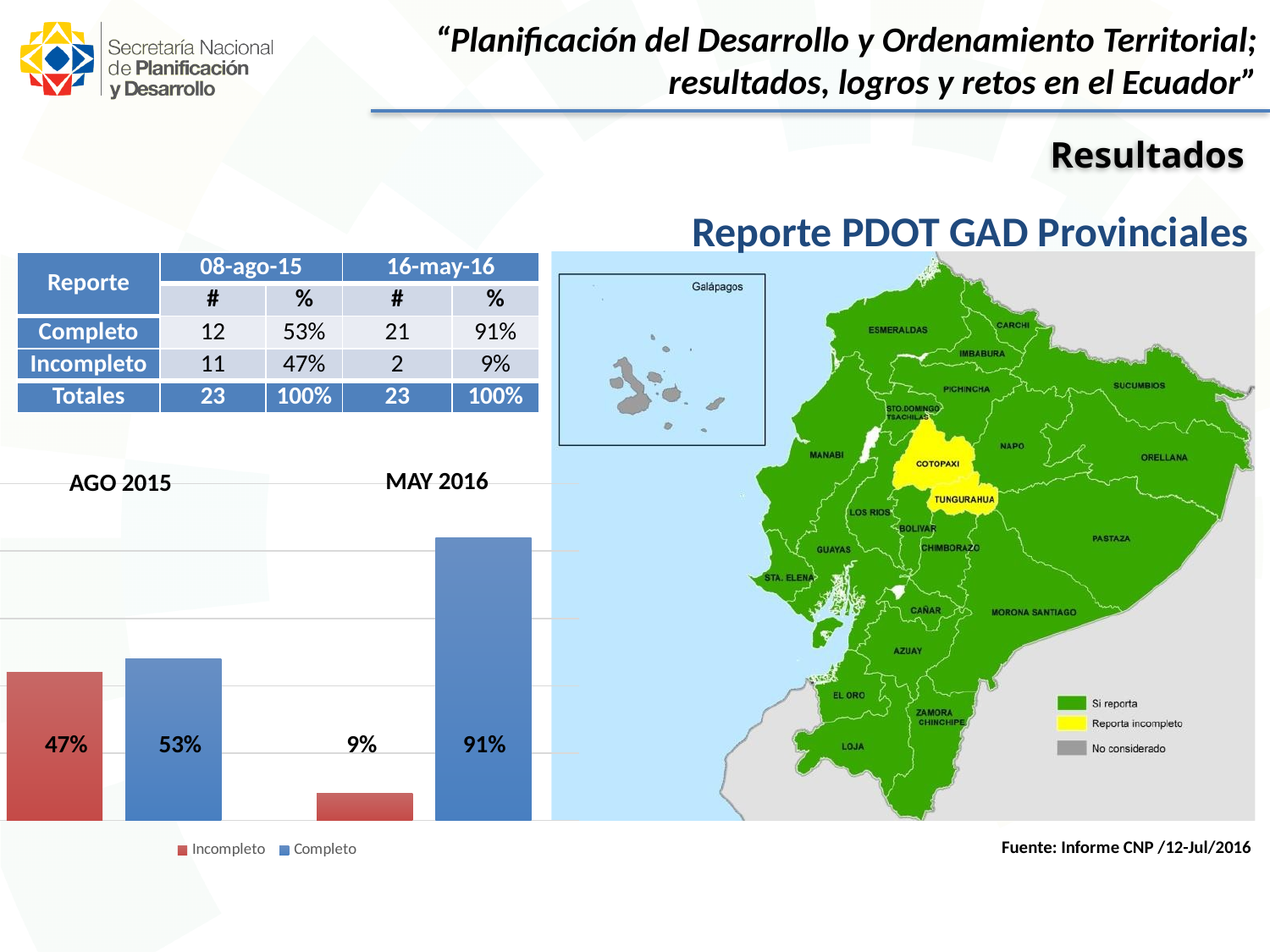
In the bar chart, what is the value for Incompleto in AGO 2015? 47% What kind of chart is shown on the left of the slide below the table? bar chart How many series does the legend of the bar chart list? 2 In the bar chart, what is the difference between the Completo values for MAY 2016 and AGO 2015? 38% In the bar chart, which bar has the highest value? Completo, MAY 2016 In the bar chart, which is larger in AGO 2015: Incompleto or Completo? Completo How many categories (time periods) are shown on the x axis of the bar chart? 2 In the bar chart, does the Incompleto value rise or fall from AGO 2015 to MAY 2016? fall In the bar chart, what is the value for Completo in MAY 2016? 91% In the bar chart, what is the value for Incompleto in MAY 2016? 9% In the bar chart, which bar has the lowest value? Incompleto, MAY 2016 In the bar chart, what is the value for Completo in AGO 2015? 53%